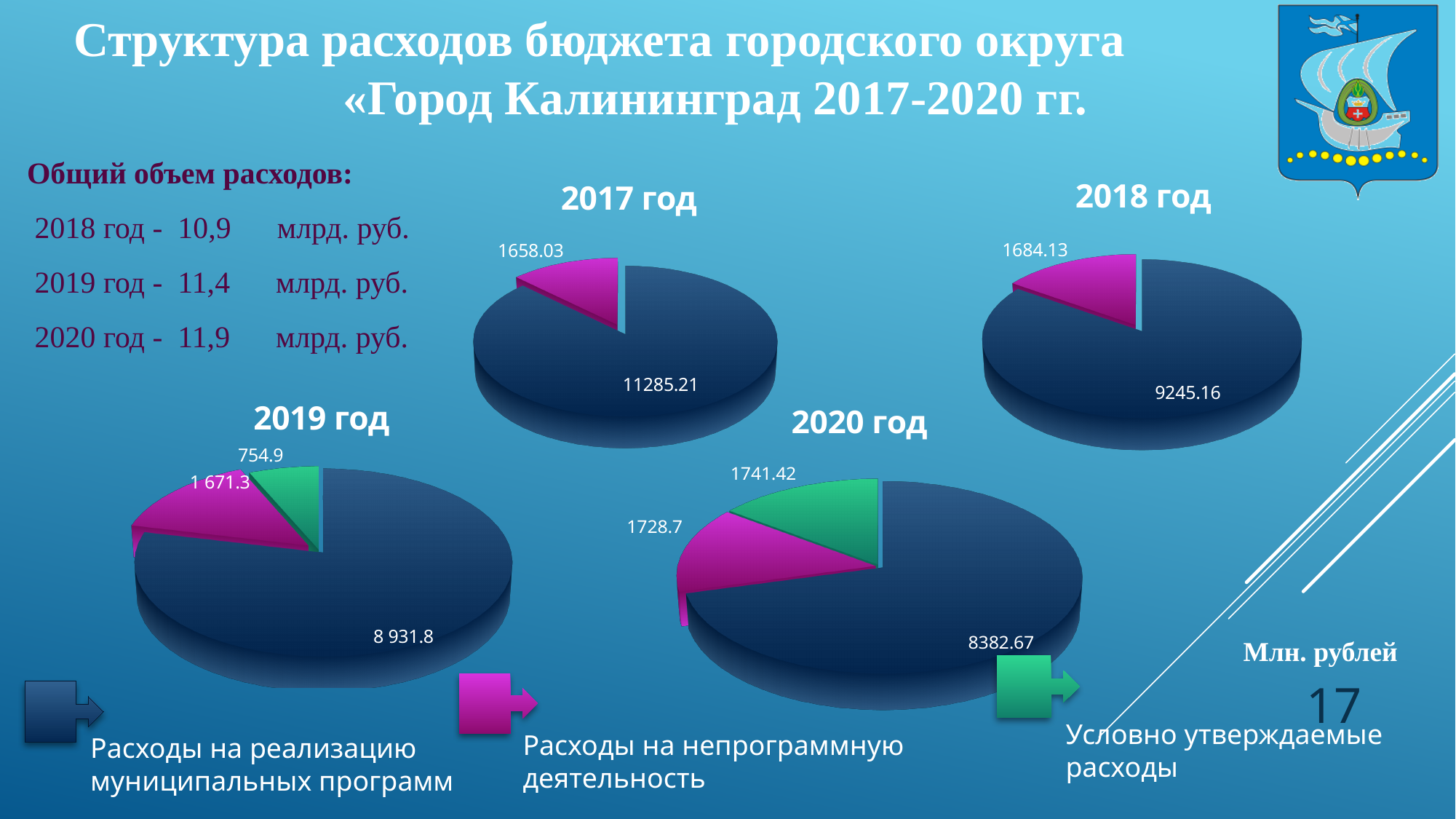
In the 2020 год pie chart, what is the value for Расходы на реализацию муниципальных программ? 8382.67 How many slices does the 2019 год pie chart have? 3 In the 2019 год pie chart, what is the value for Условно утверждаемые расходы? 754.9 What kind of chart is used for 2017 год? Pie chart In the 2020 год pie chart, which category has the largest value? Расходы на реализацию муниципальных программ How many categories does the legend at the bottom of the slide list? 3 In the 2017 год pie chart, what is the difference between Расходы на реализацию муниципальных программ and Расходы на непрограммную деятельность? 9627.18 In the 2017 год pie chart, what is the value for Расходы на реализацию муниципальных программ? 11285.21 In the 2018 год pie chart, what is the value for Расходы на непрограммную деятельность? 1684.13 In the 2018 год pie chart, which is larger: Расходы на реализацию муниципальных программ or Расходы на непрограммную деятельность? Расходы на реализацию муниципальных программ In the 2020 год pie chart, what is the difference between Условно утверждаемые расходы and Расходы на непрограммную деятельность? 12.72 In the 2019 год pie chart, which category has the smallest value? Условно утверждаемые расходы